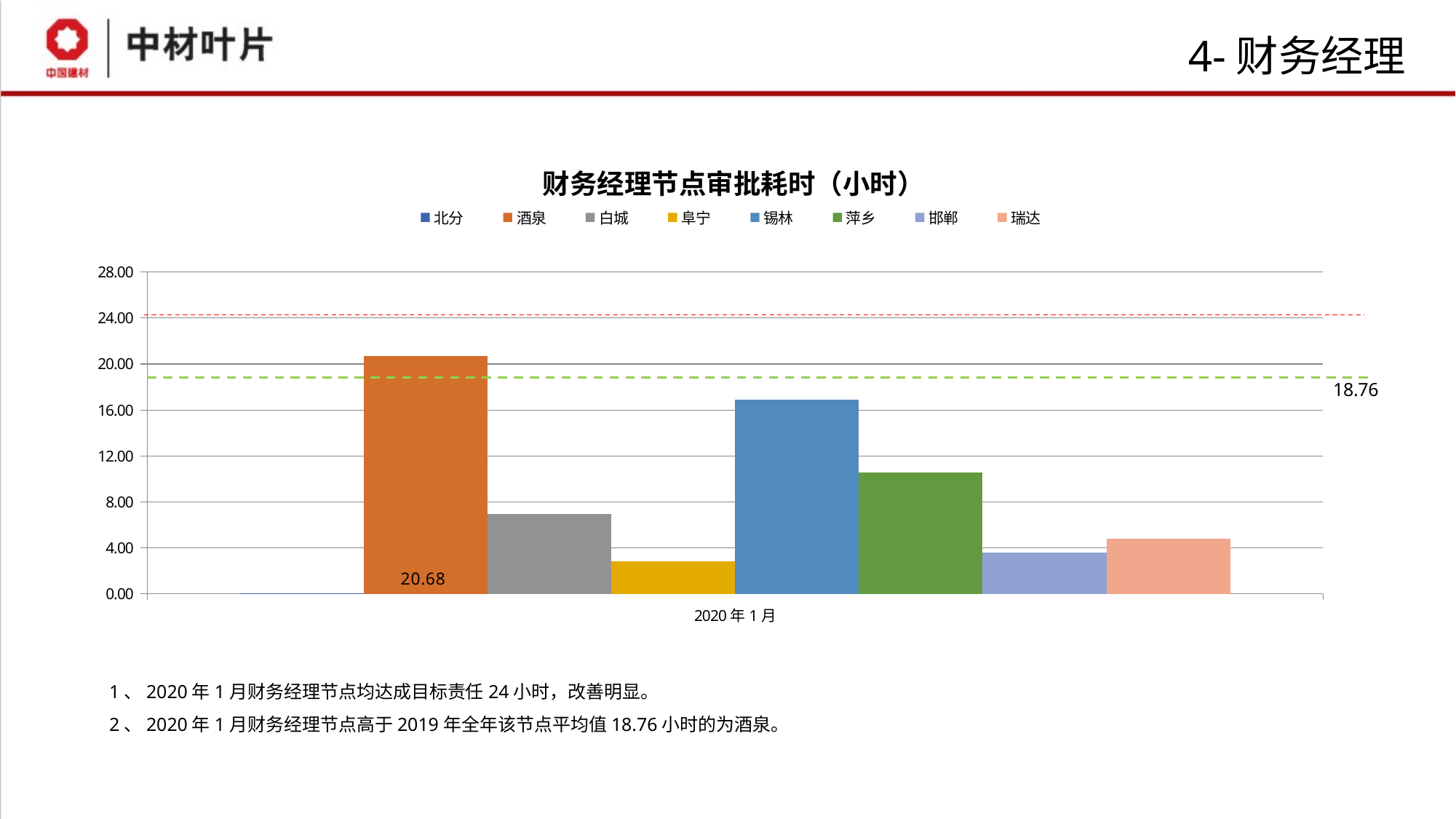
What kind of chart is shown on the slide? bar chart Which is larger, the value for 锡林 or the value for 萍乡? 锡林 Which is larger, the value for 酒泉 or the value for 锡林? 酒泉 Which series has the highest bar? 酒泉 How many series does the legend list? 8 Is the value for 锡林 greater or less than 12.00? greater Is the value for 邯郸 greater or less than 4.00? less What value is labelled on the green dashed reference line? 18.76 What is the value printed on the 酒泉 bar? 20.68 Is the value for 白城 greater or less than 8.00? less What is the title of the chart? 财务经理节点审批耗时（小时）